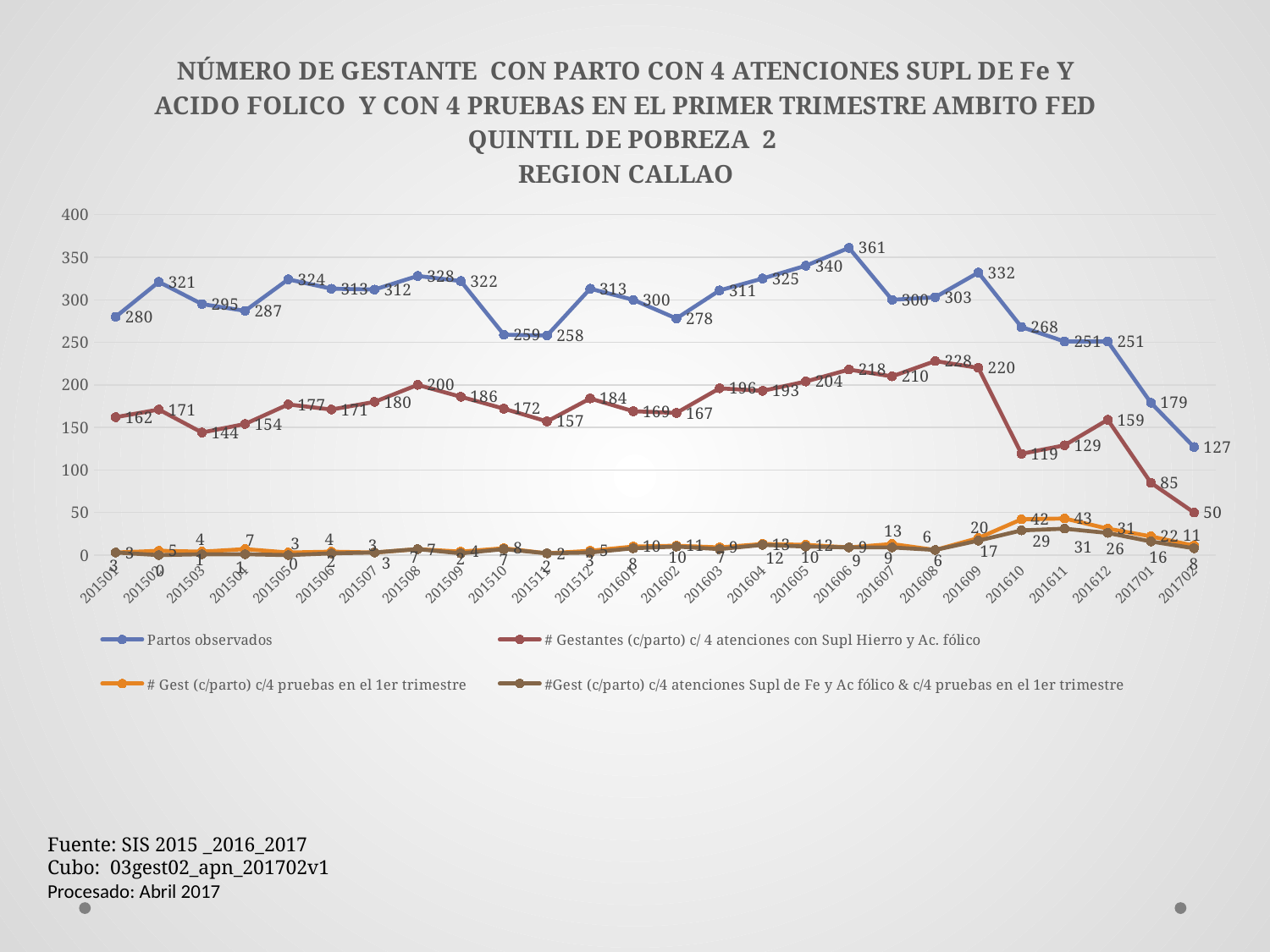
What kind of chart is shown on the slide? line chart What is the value of # Gestantes (c/parto) c/ 4 atenciones con Supl Hierro y Ac. fólico for 201702? 50 Does Partos observados rise or fall from 201609 to 201702? fall In which month is Partos observados lowest? 201702 How many months (points) are plotted along the x axis? 26 How many series does the legend list? 4 In which month is # Gestantes (c/parto) c/ 4 atenciones con Supl Hierro y Ac. fólico highest? 201608 What is the value of Partos observados for 201606? 361 Which month has the larger Partos observados value, 201502 or 201503? 201502 Is the value of Partos observados for 201606 greater or less than 350? greater In which month is Partos observados highest? 201606 What is the difference between Partos observados in 201606 and in 201702? 234